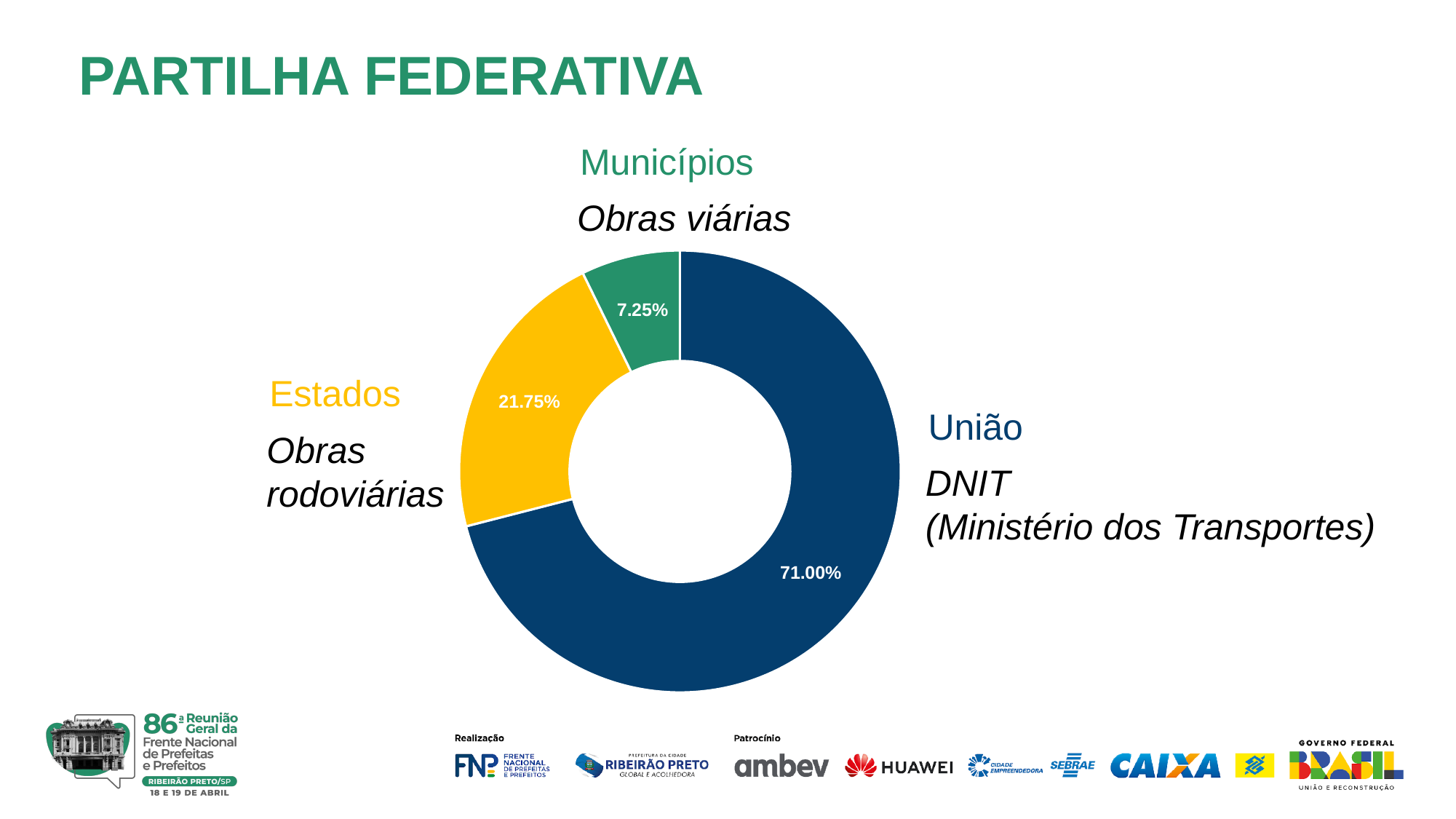
Which category has the largest share of the chart? União How many categories are shown in the chart? 3 What share of the chart does União hold? 71.00% What kind of chart is shown on the slide? Doughnut (pie) chart What is the difference in percentage points between the shares of Estados and Municípios? 14.50 What share of the chart does Estados hold? 21.75% Which category has the smallest share of the chart? Municípios Which has a larger share, Estados or Municípios? Estados What is the difference in percentage points between the shares of União and Estados? 49.25 What is the title of the slide containing the chart? PARTILHA FEDERATIVA What colour is the Estados slice of the chart? Yellow What share of the chart does Municípios hold? 7.25%